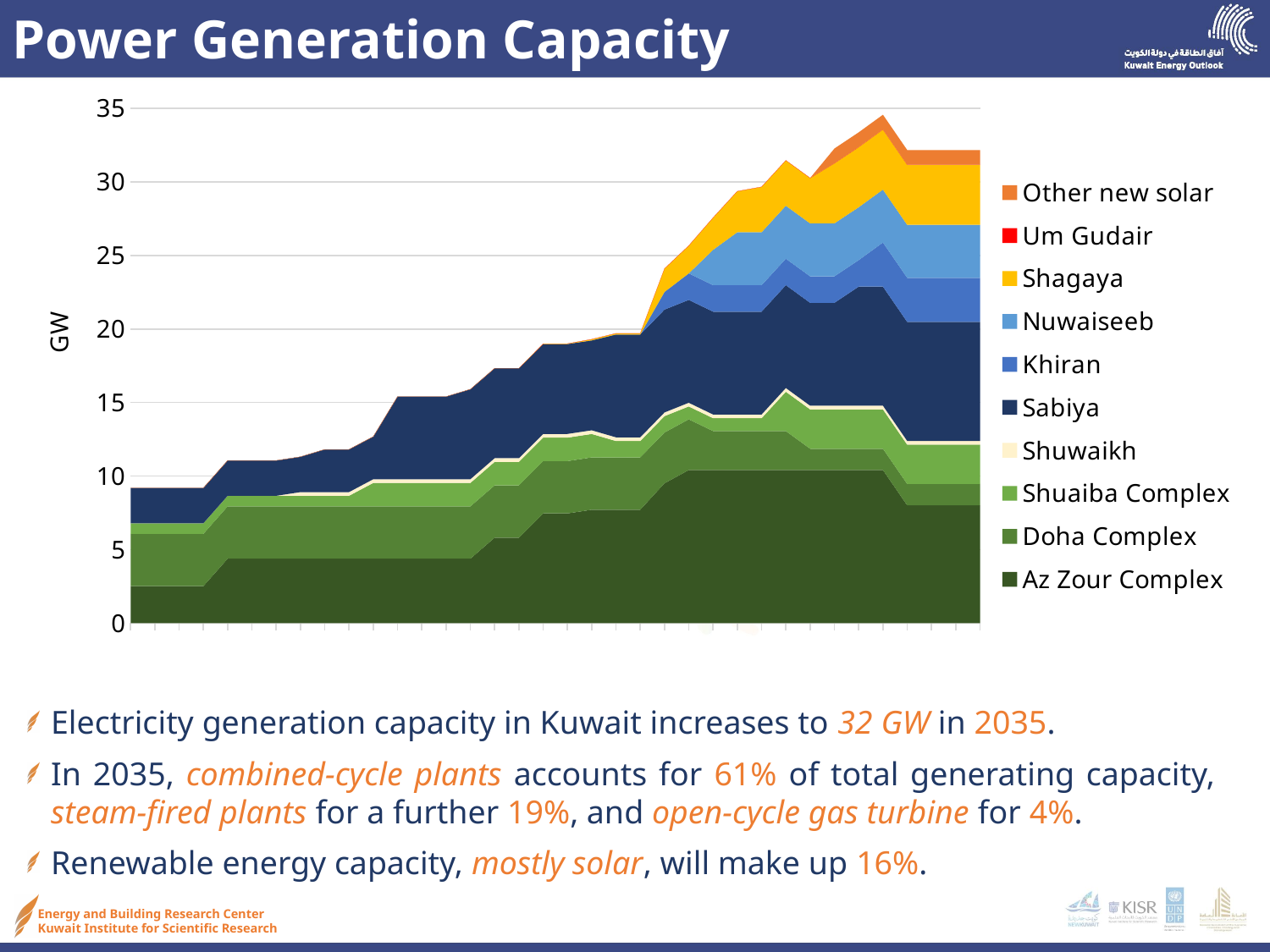
How many series does the chart's legend list? 10 Is the peak total capacity reached on the chart greater or less than 30 GW? greater Is the Az Zour Complex capacity at the right-hand end of the chart greater or less than 5 GW? greater What kind of chart is shown on the slide? Stacked area chart Does the total power generation capacity generally rise or fall from left to right across the chart? Rise Is the total capacity at the left-hand start of the chart greater or less than 15 GW? less What unit is shown on the chart's vertical axis? GW What is the title of the slide containing the chart? Power Generation Capacity What is the highest value shown on the chart's vertical axis? 35